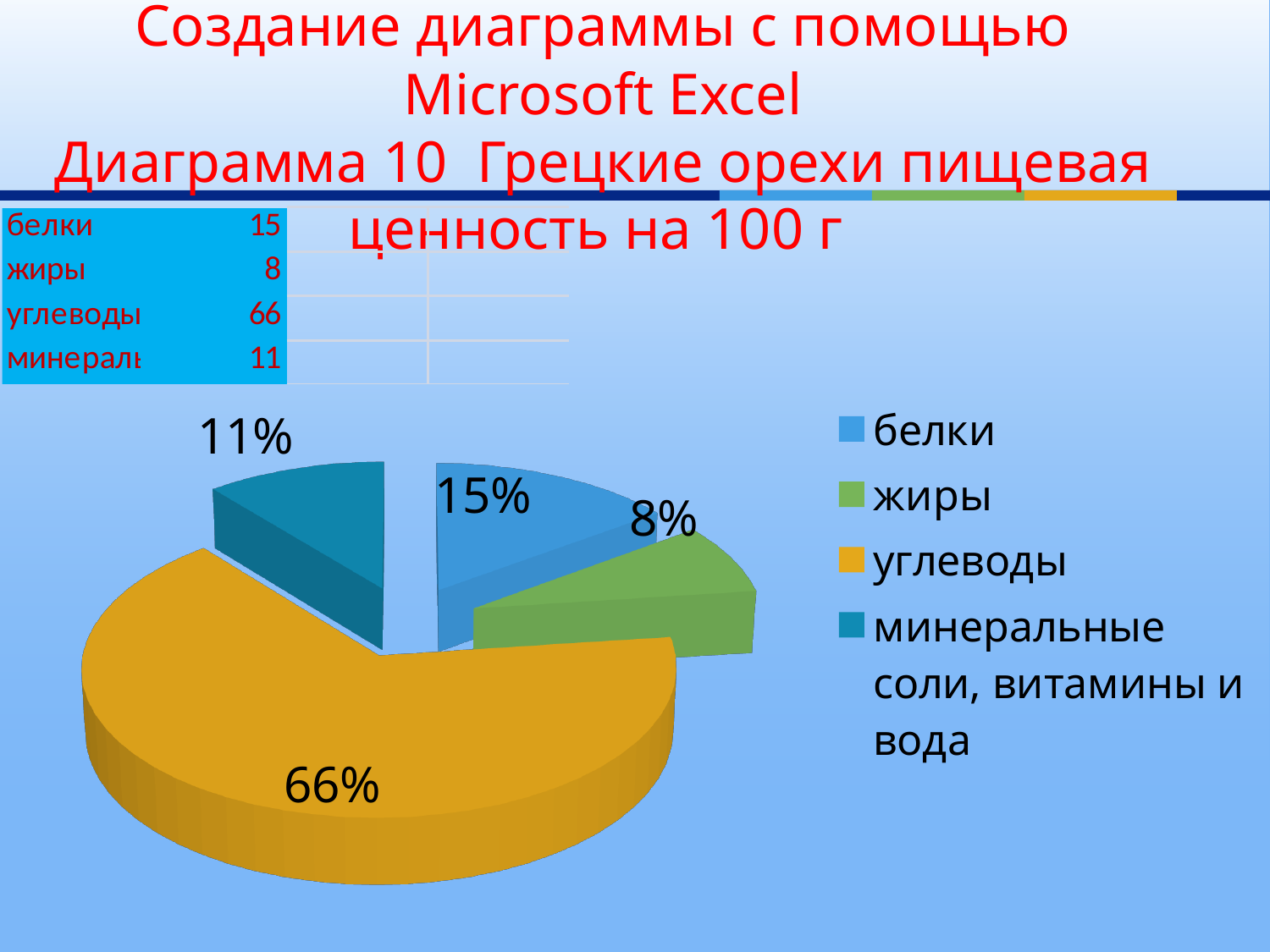
Which slice is larger, белки or минеральные соли, витамины и вода? белки How many slices does the pie chart have? 4 What percentage of the pie is labelled for белки? 15% What percentage of the pie is labelled for жиры? 8% Which category has the smallest slice of the pie? жиры What percentage of the pie is labelled for углеводы? 66% What kind of chart is shown on the slide? pie chart Which category has the largest slice of the pie? углеводы What colour is the углеводы slice in the pie chart? yellow/orange What is the difference in percentage points between the углеводы slice and the белки slice? 51 How many entries does the legend list? 4 What percentage of the pie is labelled for минеральные соли, витамины и вода? 11%